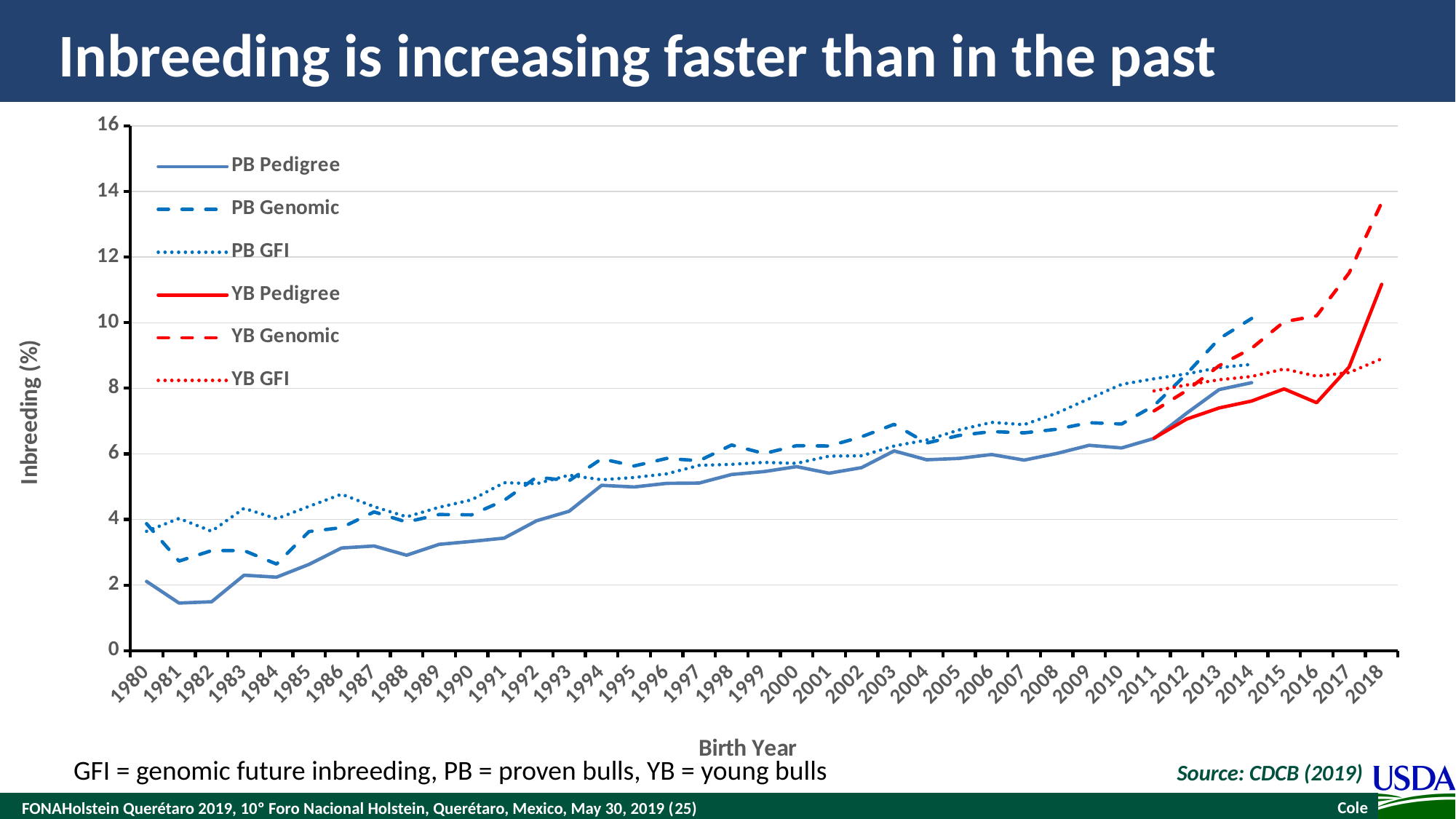
What kind of chart is shown on the slide? Line chart How many series does the legend list? 6 In 2018, which is larger: YB Genomic or YB GFI? YB Genomic What is the title of the chart on the slide? Inbreeding is increasing faster than in the past Is the value for YB GFI in 2018 greater or less than 10? less Does the PB Pedigree series generally rise or fall from 1980 to 2014? Rise Which series reaches the highest value in 2018? YB Genomic What is the label of the y axis? Inbreeding (%) Which series has the lowest value in 1981? PB Pedigree How many birth years are shown along the x axis? 39 Is the value for YB Genomic in 2018 greater or less than 12? greater Is the value for PB Pedigree in 1981 greater or less than 2? less